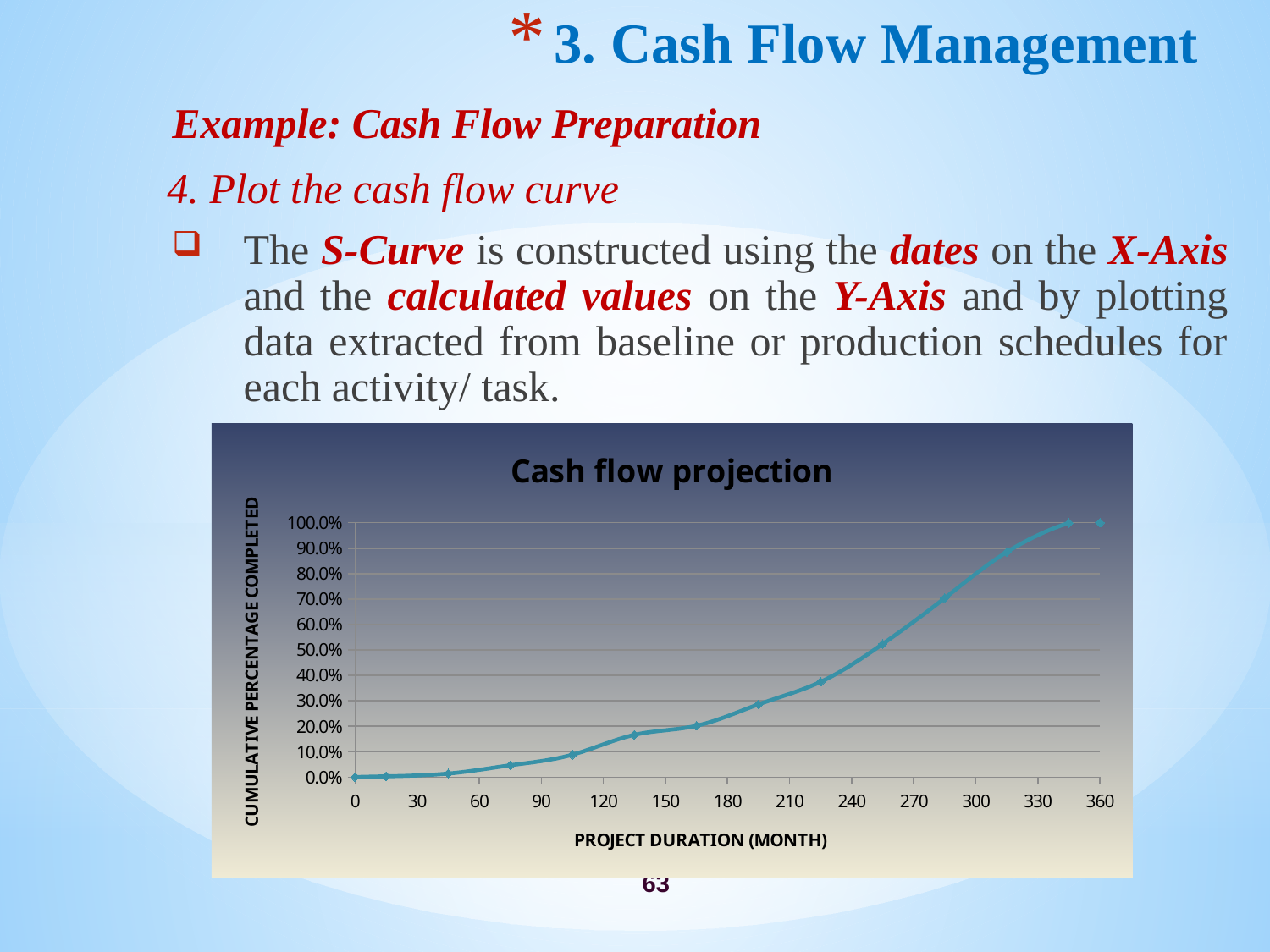
What is the highest value shown on the vertical axis of the chart? 100.0% Do the values on the chart rise or fall as project duration increases along the x axis? rise Is the cumulative percentage completed at month 255 greater or less than 40.0%? greater What is the label of the vertical axis of the chart? CUMULATIVE PERCENTAGE COMPLETED Is the cumulative percentage completed at month 195 greater or less than 40.0%? less What kind of chart is the "Cash flow projection" chart? line chart Is the cumulative percentage completed at month 45 greater or less than 10.0%? less What is the title of the chart on the slide? Cash flow projection Which is larger, the cumulative percentage completed at month 135 or at month 255? month 255